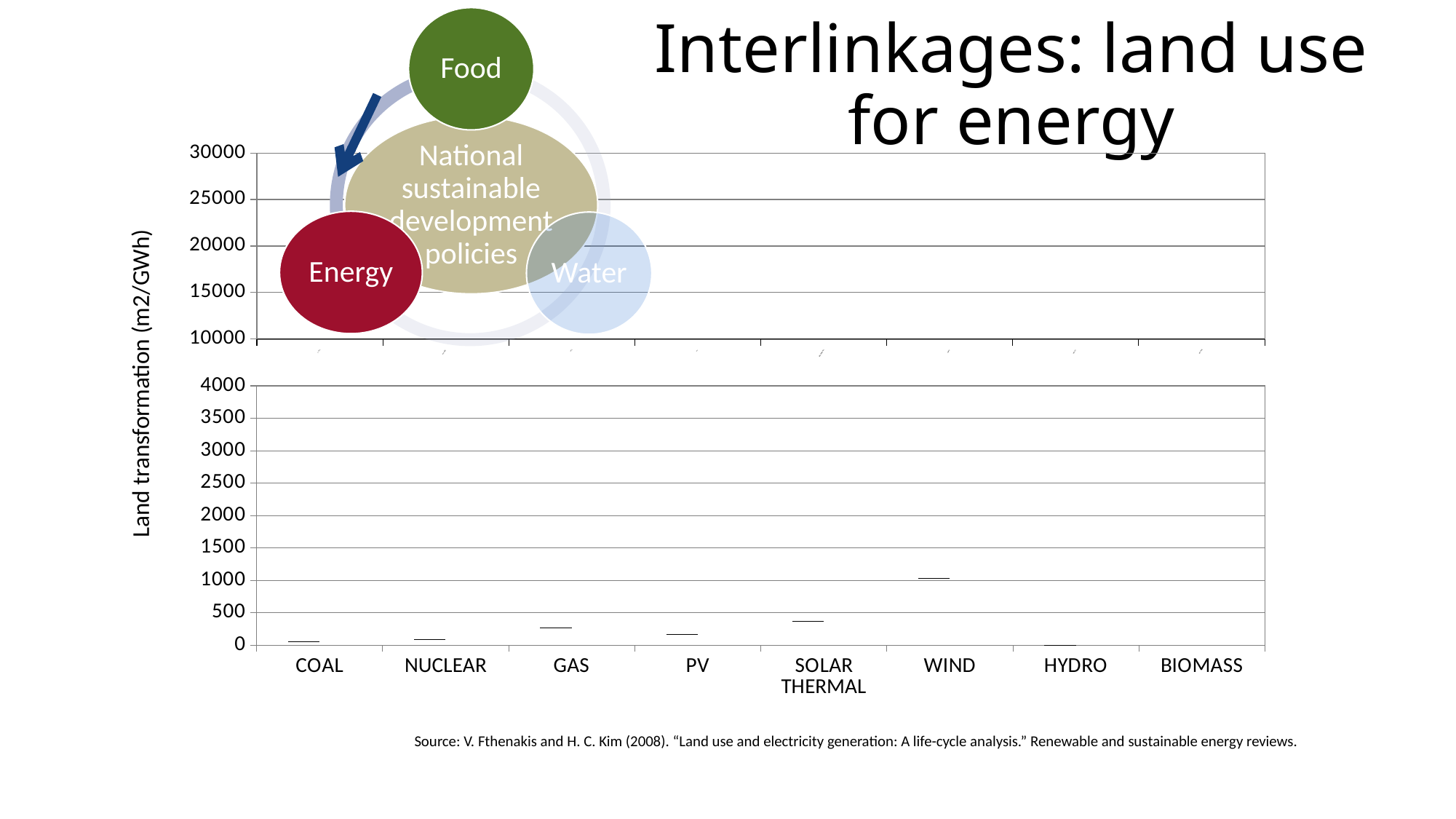
What is the label on the vertical axis of the chart? Land transformation (m2/GWh) Is the value for GAS greater or less than 500? less Is the value for NUCLEAR greater or less than 500? less Which has the larger value, SOLAR THERMAL or PV? SOLAR THERMAL Which has the larger value, WIND or COAL? WIND Which has the larger value, GAS or NUCLEAR? GAS How many energy source categories are shown on the x axis of the chart? 8 Is the value for WIND greater or less than 500? greater What is the title of the slide containing the chart? Interlinkages: land use for energy